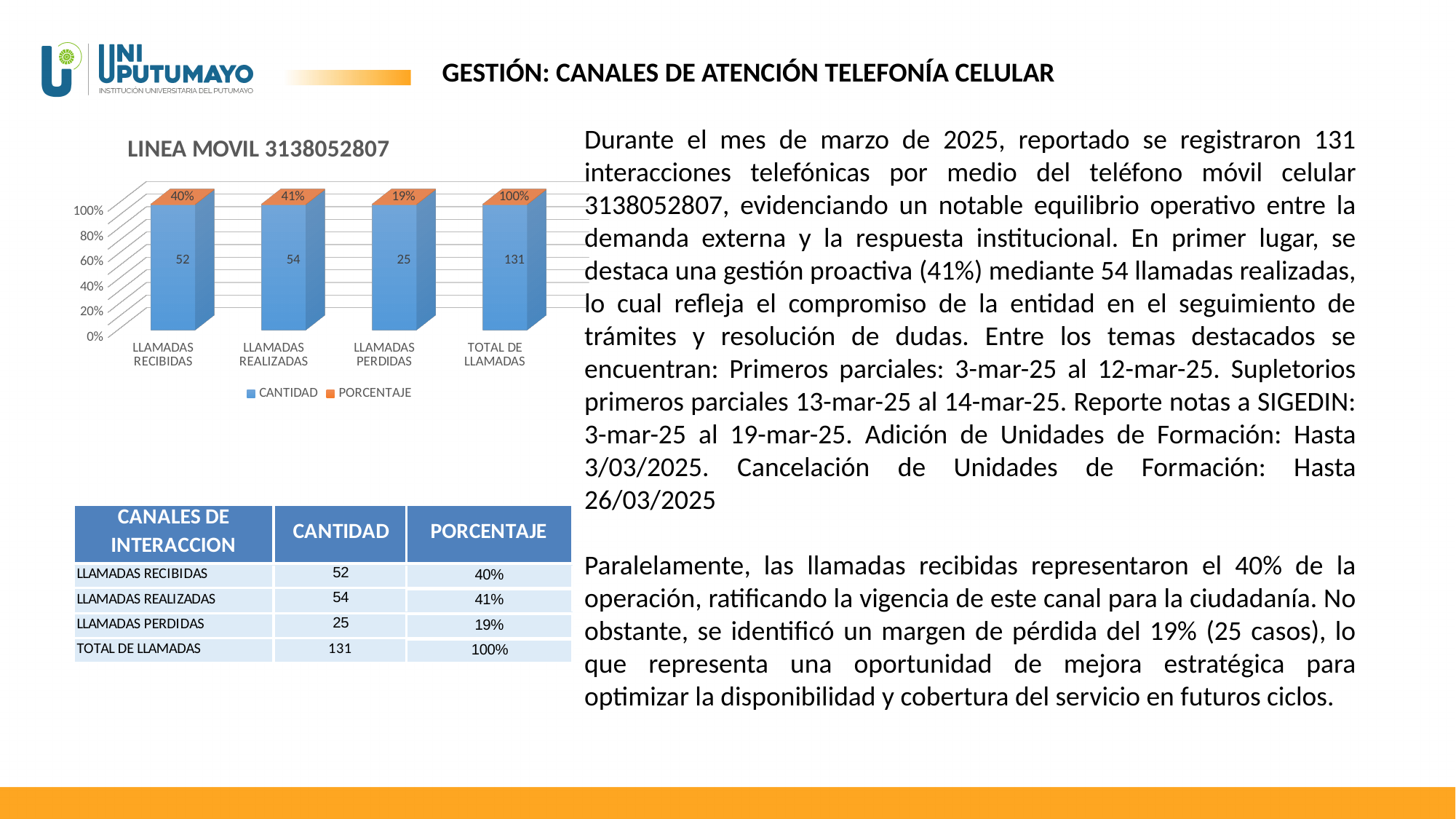
Which category has the lowest CANTIDAD value? LLAMADAS PERDIDAS What type of chart is shown on the slide? bar chart What is the difference in CANTIDAD between LLAMADAS REALIZADAS and LLAMADAS RECIBIDAS? 2 What is the CANTIDAD value for TOTAL DE LLAMADAS? 131 Which category has the highest CANTIDAD value? TOTAL DE LLAMADAS How many categories are shown on the x axis of the chart? 4 How many series does the chart legend list? 2 What is the CANTIDAD value for LLAMADAS PERDIDAS? 25 What is the CANTIDAD value for LLAMADAS RECIBIDAS? 52 Which series is shown in orange in the chart legend? PORCENTAJE What is the title of the chart? LINEA MOVIL 3138052807 What is the PORCENTAJE value for LLAMADAS REALIZADAS? 41%